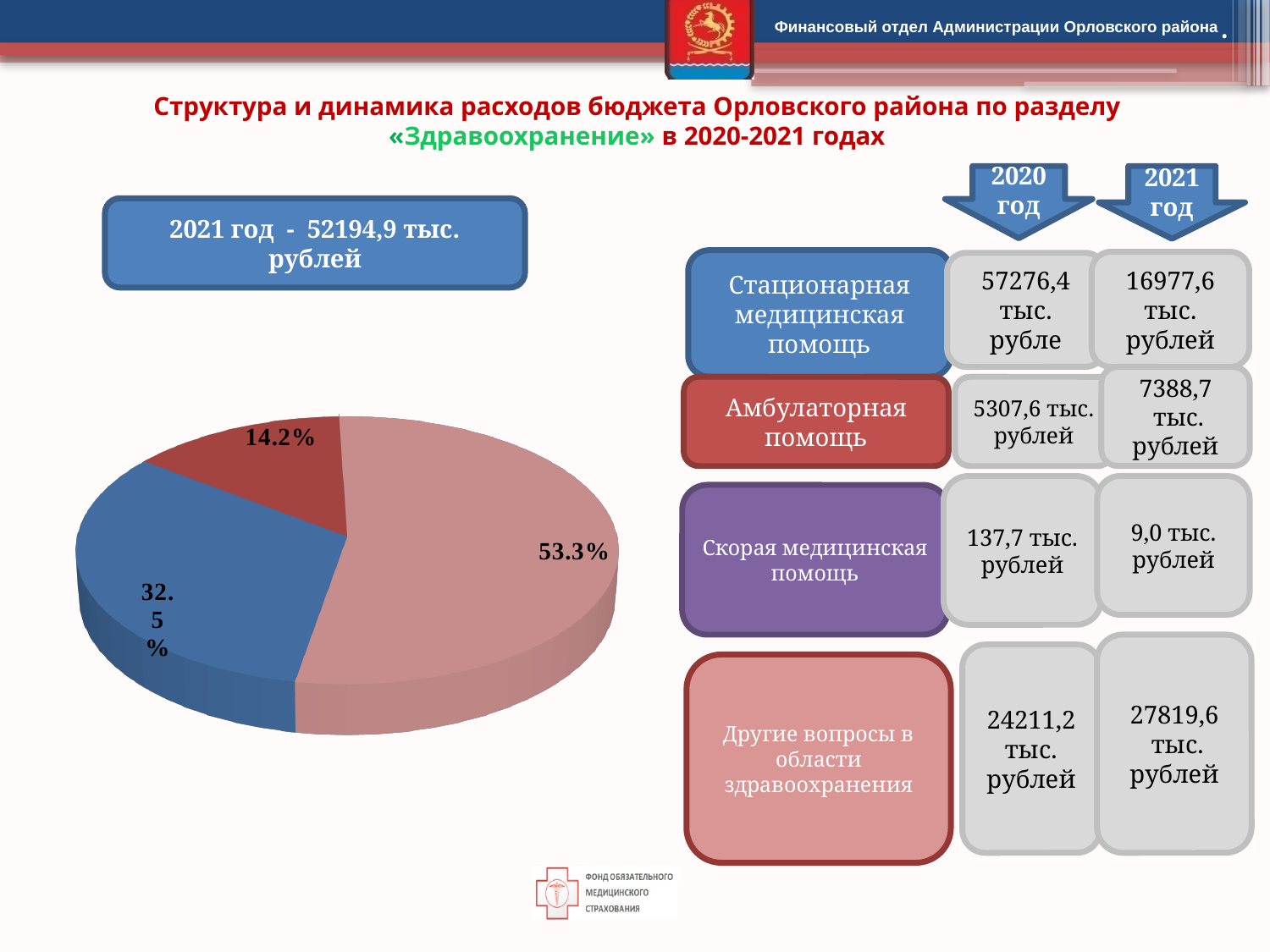
What is the share of the largest slice in the pie chart? 53.3% What colour is the largest slice of the pie chart? pink What total amount for 2021 is shown in the box above the pie chart? 52194,9 тыс. рублей What is the share of the dark red slice in the pie chart? 14.2% What is the share of the blue slice in the pie chart? 32.5% What is the difference between the largest and smallest slices in the pie chart? 39.1% What is the share of the smallest slice in the pie chart? 14.2% How many slices does the pie chart have? 3 Which slice is larger in the pie chart, the blue one or the dark red one? the blue one What is the difference between the blue slice and the dark red slice in the pie chart? 18.3% What kind of chart is shown on the left of the slide? pie chart By how many percentage points does the pink slice exceed the blue slice in the pie chart? 20.8%